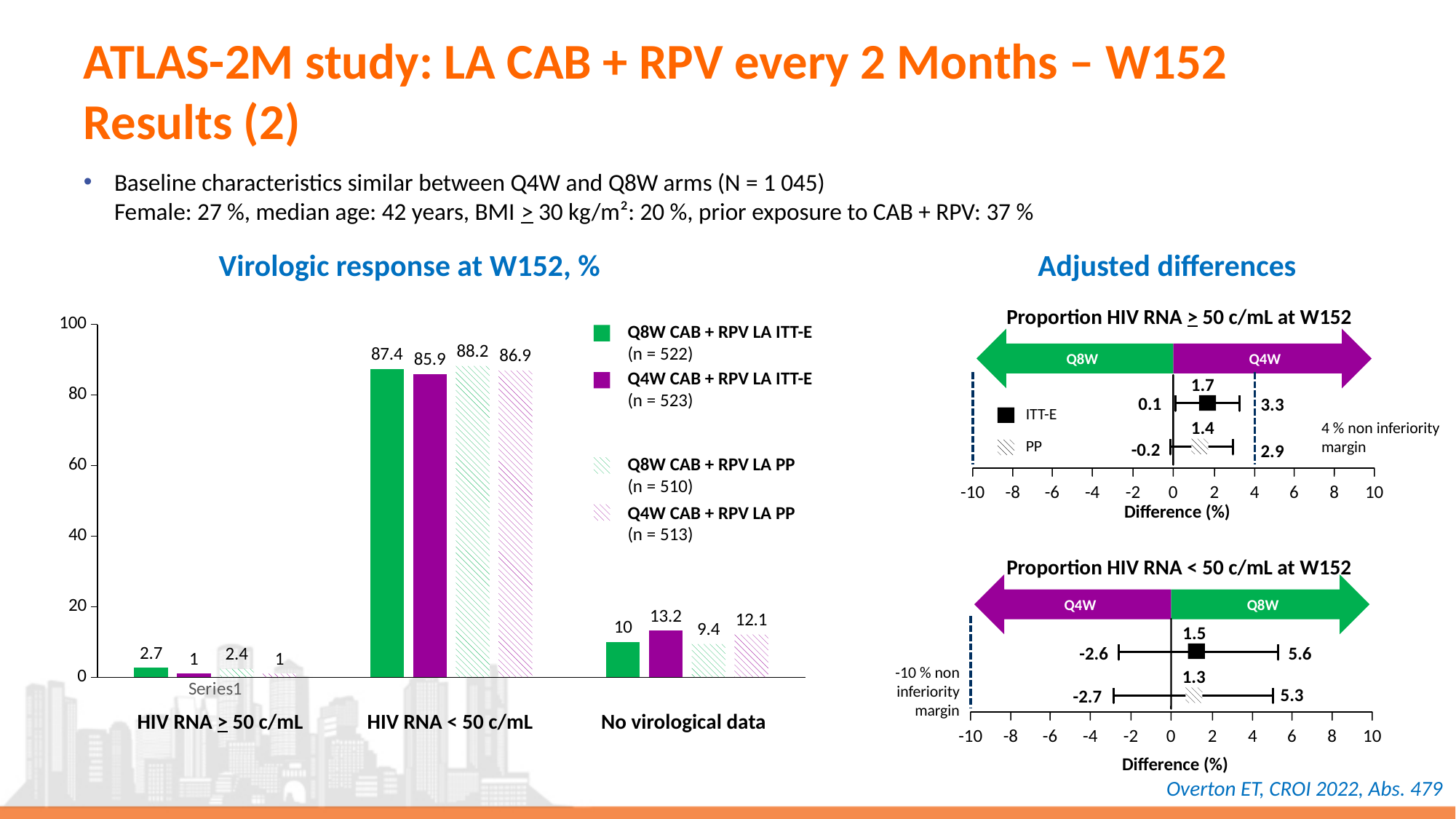
In the 'Virologic response at W152, %' chart, which series has the lowest value in the No virological data category? Q8W CAB + RPV LA PP In the 'Virologic response at W152, %' chart, what is the difference between the Q8W ITT-E and Q4W ITT-E values in the HIV RNA < 50 c/mL category? 1.5 In the 'Virologic response at W152, %' chart, what is the value for Q4W CAB + RPV LA ITT-E in the No virological data category? 13.2 What kind of chart is the 'Virologic response at W152, %' chart? Bar chart In the 'Adjusted differences' plot for Proportion HIV RNA < 50 c/mL at W152, what is the upper confidence limit for the PP analysis? 5.3 How many series does the legend of the 'Virologic response at W152, %' chart list? 4 In the 'Adjusted differences' plot for Proportion HIV RNA ≥ 50 c/mL at W152, what is the ITT-E point estimate of the difference? 1.7 In the 'Virologic response at W152, %' chart, what is the value for Q8W CAB + RPV LA PP in the HIV RNA ≥ 50 c/mL category? 2.4 In the 'Virologic response at W152, %' chart, which series has the highest value in the HIV RNA < 50 c/mL category? Q8W CAB + RPV LA PP In the 'Virologic response at W152, %' chart, what is the value for Q8W CAB + RPV LA ITT-E in the HIV RNA < 50 c/mL category? 87.4 How many categories are shown on the x axis of the 'Virologic response at W152, %' chart? 3 In the 'Virologic response at W152, %' chart, which is larger in the No virological data category: Q8W CAB + RPV LA ITT-E or Q4W CAB + RPV LA ITT-E? Q4W CAB + RPV LA ITT-E